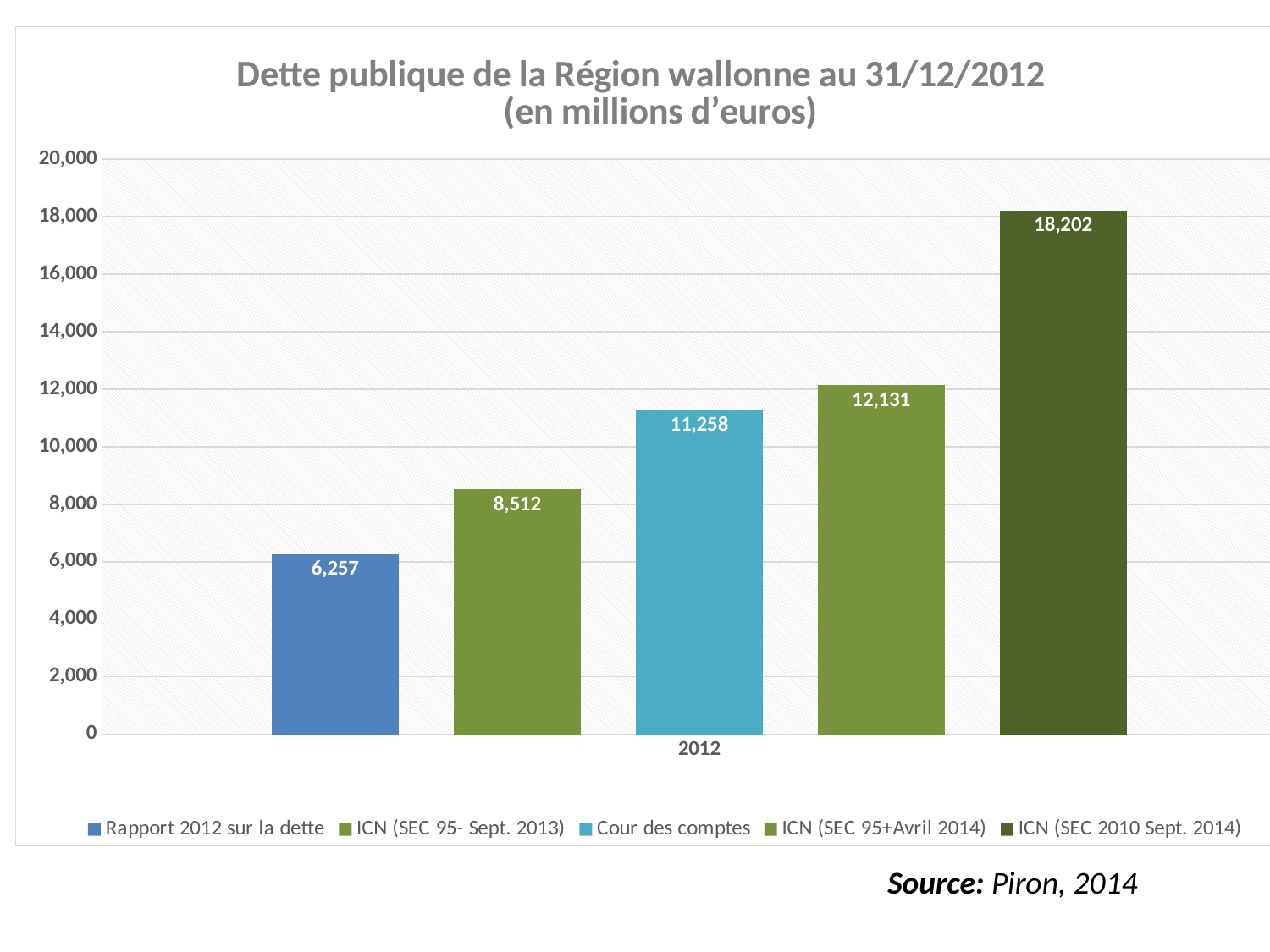
Is the value for ICN (SEC 95- Sept. 2013) greater or less than 10,000? less What is the value for Cour des comptes? 11,258 What is the value for ICN (SEC 95+Avril 2014)? 12,131 What is the difference between the values for ICN (SEC 2010 Sept. 2014) and ICN (SEC 95+Avril 2014)? 6,071 What is the value for ICN (SEC 2010 Sept. 2014)? 18,202 Which series has the highest value? ICN (SEC 2010 Sept. 2014) What kind of chart is shown? bar chart What is the title of the chart? Dette publique de la Région wallonne au 31/12/2012 (en millions d'euros) Which is larger, the value for ICN (SEC 95- Sept. 2013) or the value for Cour des comptes? Cour des comptes How many series does the legend list? 5 What is the value for Rapport 2012 sur la dette? 6,257 Which series has the lowest value? Rapport 2012 sur la dette